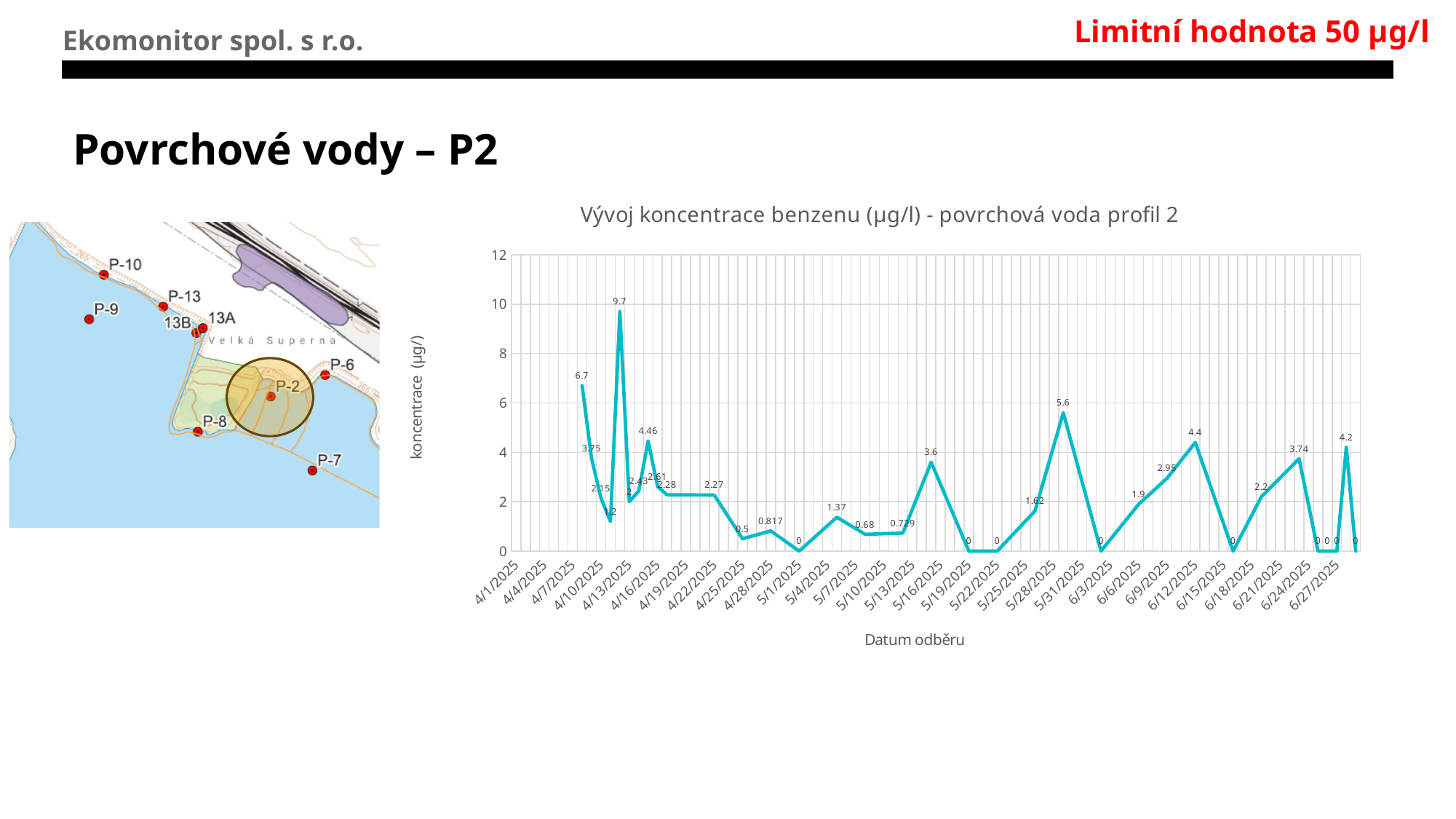
What is the highest benzene concentration value plotted on the chart? 9.7 What is the label of the y axis of the chart? koncentrace (µg/l) What is the title of the chart? Vývoj koncentrace benzenu (µg/l) - povrchová voda profil 2 What type of chart is shown on the slide? line chart What is the benzene concentration at the peak around 6/12/2025? 4.4 Is the highest value on the chart greater or less than 8? greater What is the lowest benzene concentration value plotted on the chart? 0 What is the difference between the highest value (9.7) and the first plotted value (6.7)? 3 What is the benzene concentration at the peak around 4/13/2025? 9.7 Does the benzene concentration generally rise or fall from the start of April to the end of June? fall Which is larger, the peak value of 5.6 or the peak value of 4.46? 5.6 What is the benzene concentration at the peak around 5/28/2025? 5.6